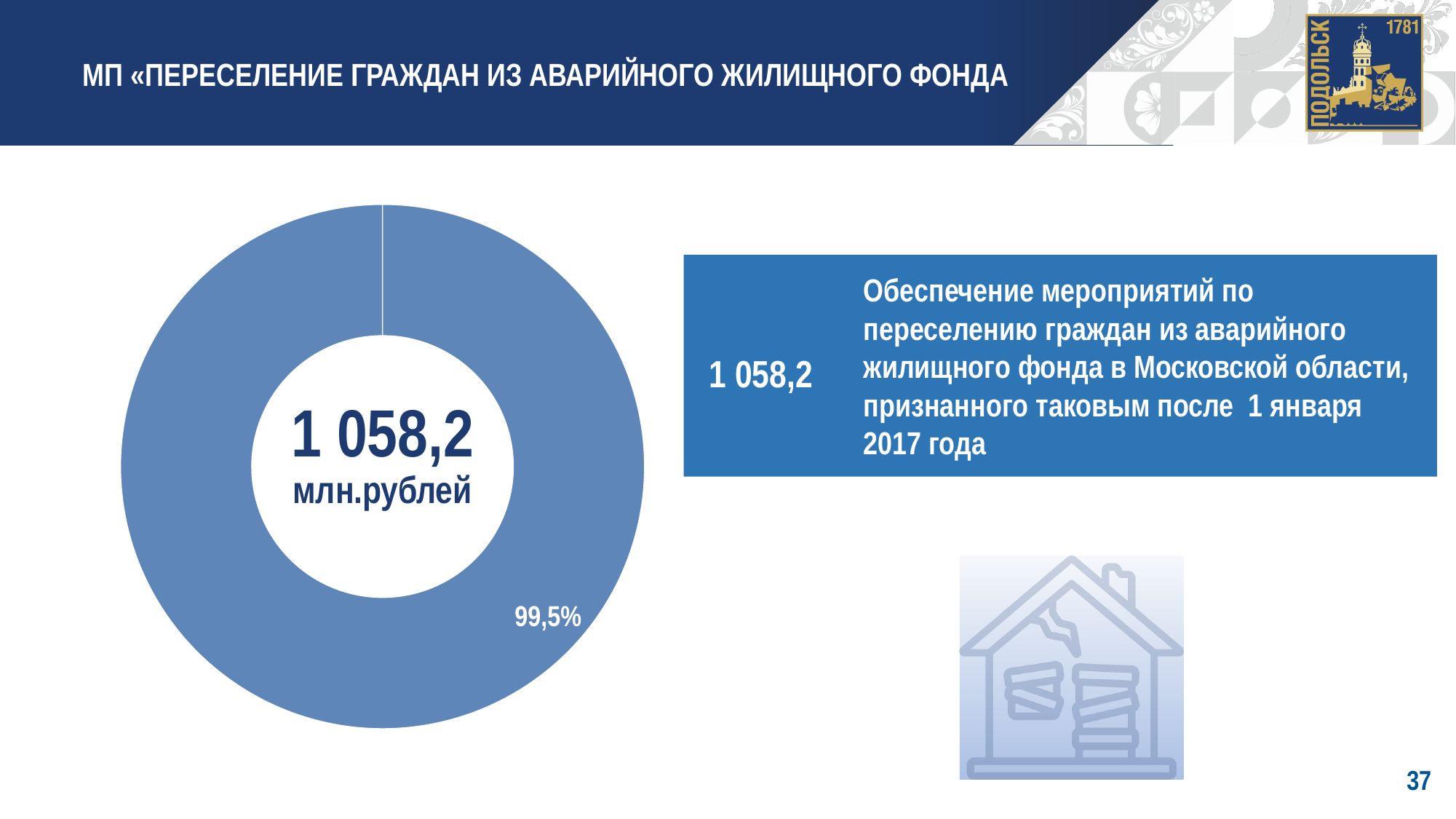
What unit is shown under the number in the centre of the doughnut chart? млн.рублей What percentage is printed on the large blue slice of the doughnut chart? 99,5% What value is printed in the centre of the doughnut chart? 1 058,2 млн.рублей Does the doughnut chart have a legend? No What colour is the large slice of the doughnut chart? Blue What kind of chart is shown on the left of the slide? Doughnut (pie) chart Is the share of the labelled slice in the doughnut chart greater or less than 50%? greater What value is shown in the blue text box to the right of the doughnut chart? 1 058,2